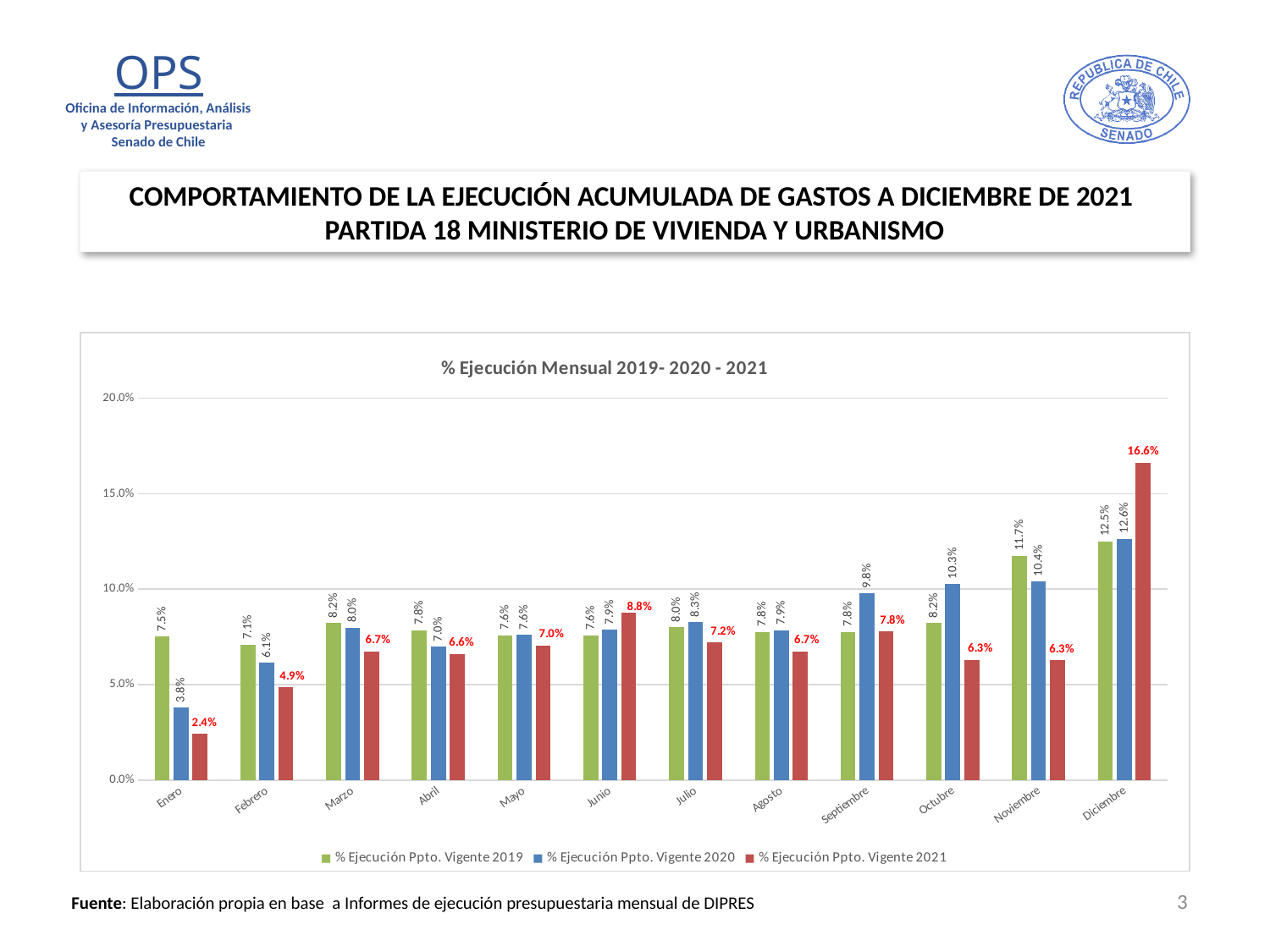
What is the value for % Ejecución Ppto. Vigente 2020 in Enero? 3.8% What is the value for % Ejecución Ppto. Vigente 2019 in Noviembre? 11.7% How many months are shown on the x axis? 12 What kind of chart is shown on the slide? Bar chart Which month has the highest value for % Ejecución Ppto. Vigente 2020? Diciembre What is the difference between the 2021 and 2019 values in Diciembre? 4.1% In Octubre, which series has the larger value: % Ejecución Ppto. Vigente 2020 or % Ejecución Ppto. Vigente 2021? % Ejecución Ppto. Vigente 2020 Is the value for % Ejecución Ppto. Vigente 2021 in Diciembre greater or less than 15.0%? greater What is the value for % Ejecución Ppto. Vigente 2021 in Diciembre? 16.6% How many series does the legend list? 3 Which month has the lowest value for % Ejecución Ppto. Vigente 2021? Enero What is the value for % Ejecución Ppto. Vigente 2021 in Junio? 8.8%